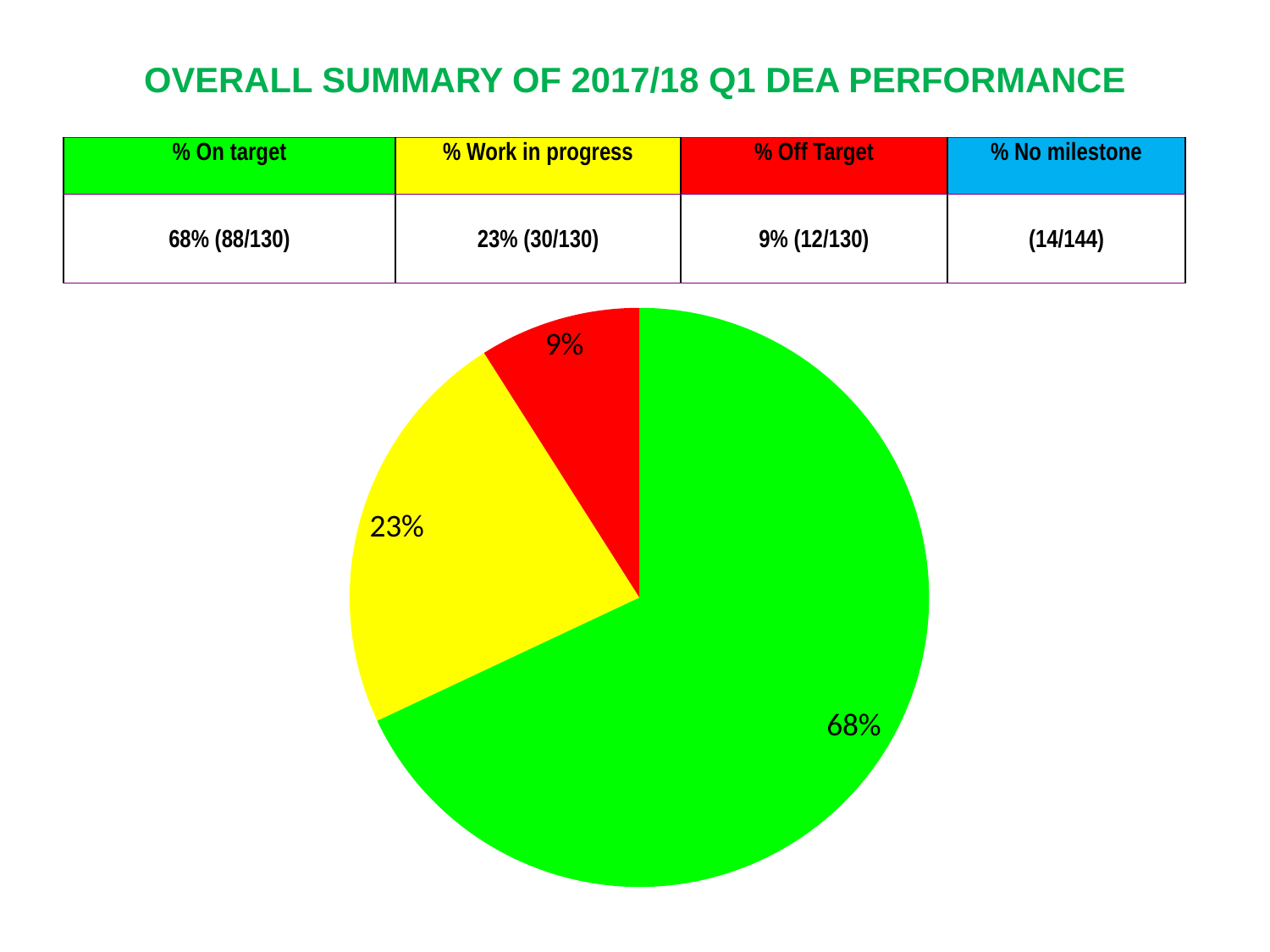
Which is larger in the pie chart, the yellow slice or the red slice? The yellow slice What percentage is shown on the yellow slice of the pie chart? 23% What share of the pie does the green slice represent? 68% Which slice of the pie chart is the largest? The green slice (68%) How many slices does the pie chart have? 3 What is the difference between the green slice and the yellow slice of the pie chart? 45% What percentage is shown on the red slice of the pie chart? 9% Which slice of the pie chart is the smallest? The red slice (9%) What percentage is shown on the green slice of the pie chart? 68% According to the table above the pie chart, which category does the red colour represent? % Off Target What kind of chart is shown on the slide? Pie chart What is the difference between the yellow slice and the red slice of the pie chart? 14%